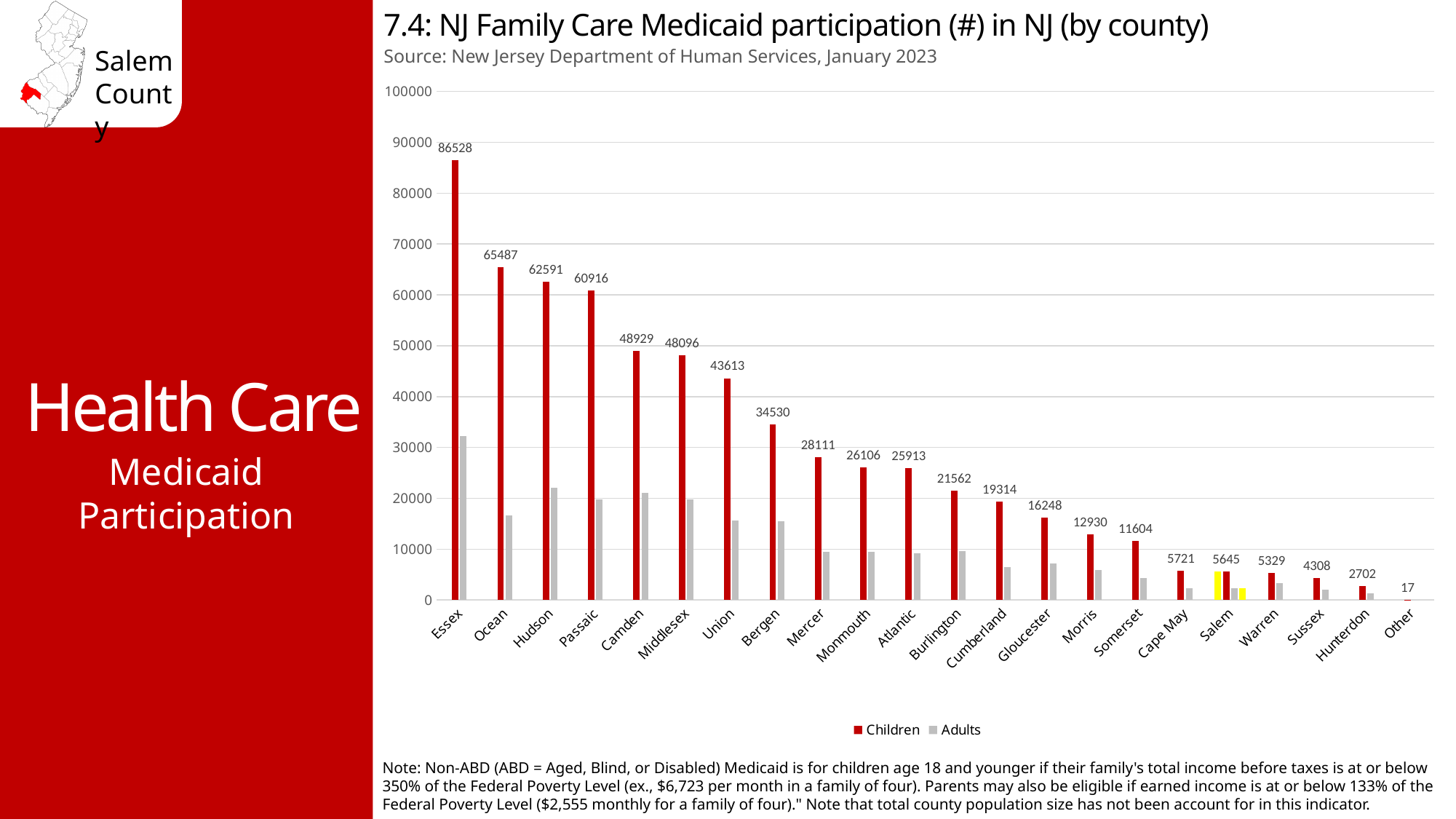
Is the Adults value for Hudson greater or less than 30000? less Which category has the lowest Children value? Other What is the Children value for Salem? 5645 How many categories are shown on the x axis? 22 How many series does the legend list? 2 Which has a larger Children value, Camden or Union? Camden What is the difference between the Children values for Ocean and Hudson? 2896 What kind of chart is shown? Bar chart Is the Adults value for Essex greater or less than 30000? greater What is the Children value for Cumberland? 19314 Which county has the highest Children value? Essex What is the Children value for Essex? 86528